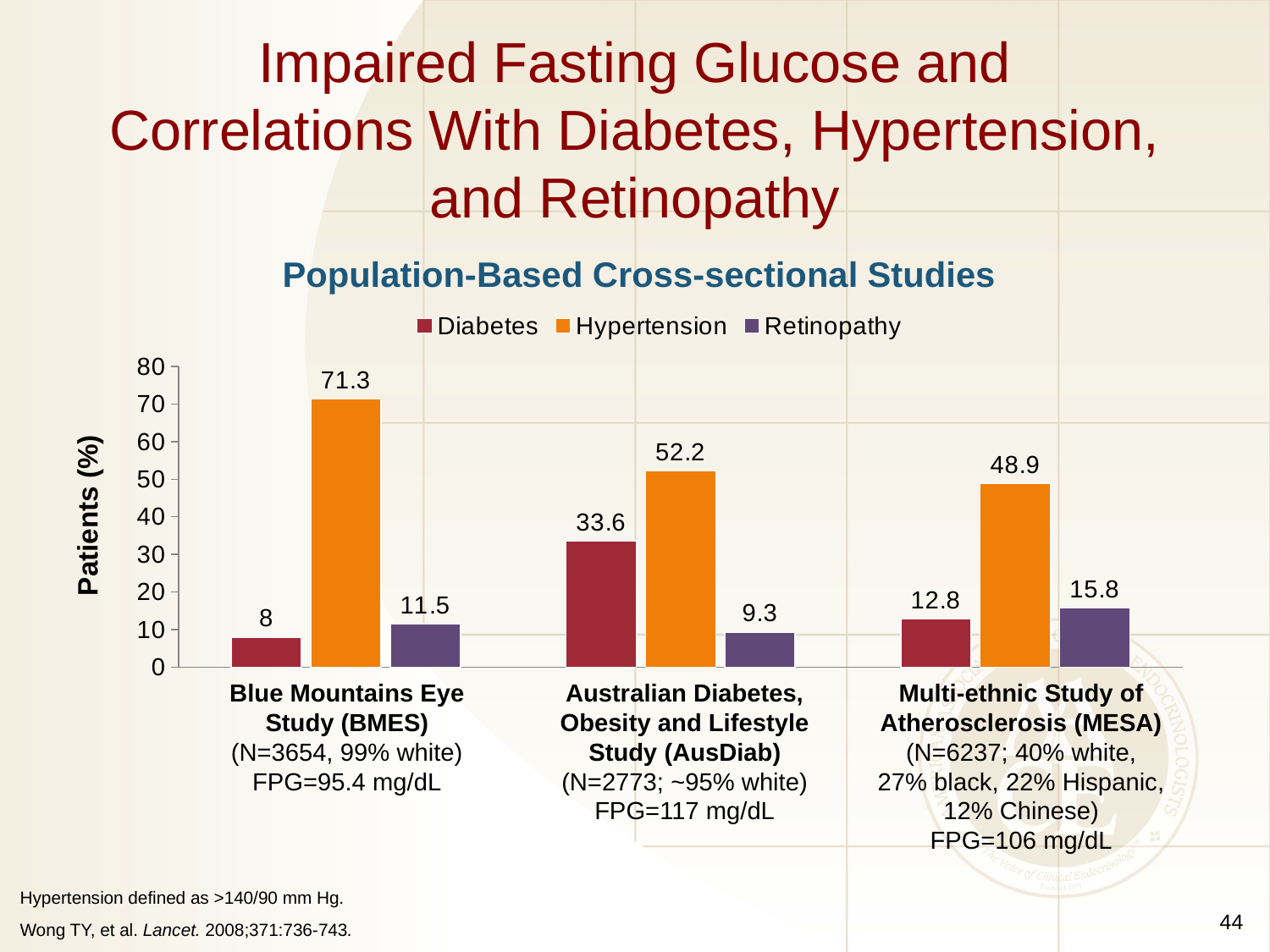
How many series does the legend list? 3 What is the Hypertension value for the Blue Mountains Eye Study (BMES)? 71.3 How many studies are shown on the x axis? 3 What kind of chart is shown on the slide? Bar chart What is the Diabetes value for the Australian Diabetes, Obesity and Lifestyle Study (AusDiab)? 33.6 Is the Hypertension value for AusDiab greater or less than 50? greater What is the label of the y axis? Patients (%) Which study has the lowest Diabetes value? Blue Mountains Eye Study (BMES) Which is larger: the Retinopathy value for BMES or the Retinopathy value for AusDiab? BMES What is the Retinopathy value for the Multi-ethnic Study of Atherosclerosis (MESA)? 15.8 Which study has the highest Hypertension value? Blue Mountains Eye Study (BMES) What is the difference between the Hypertension and Diabetes values for the Multi-ethnic Study of Atherosclerosis (MESA)? 36.1